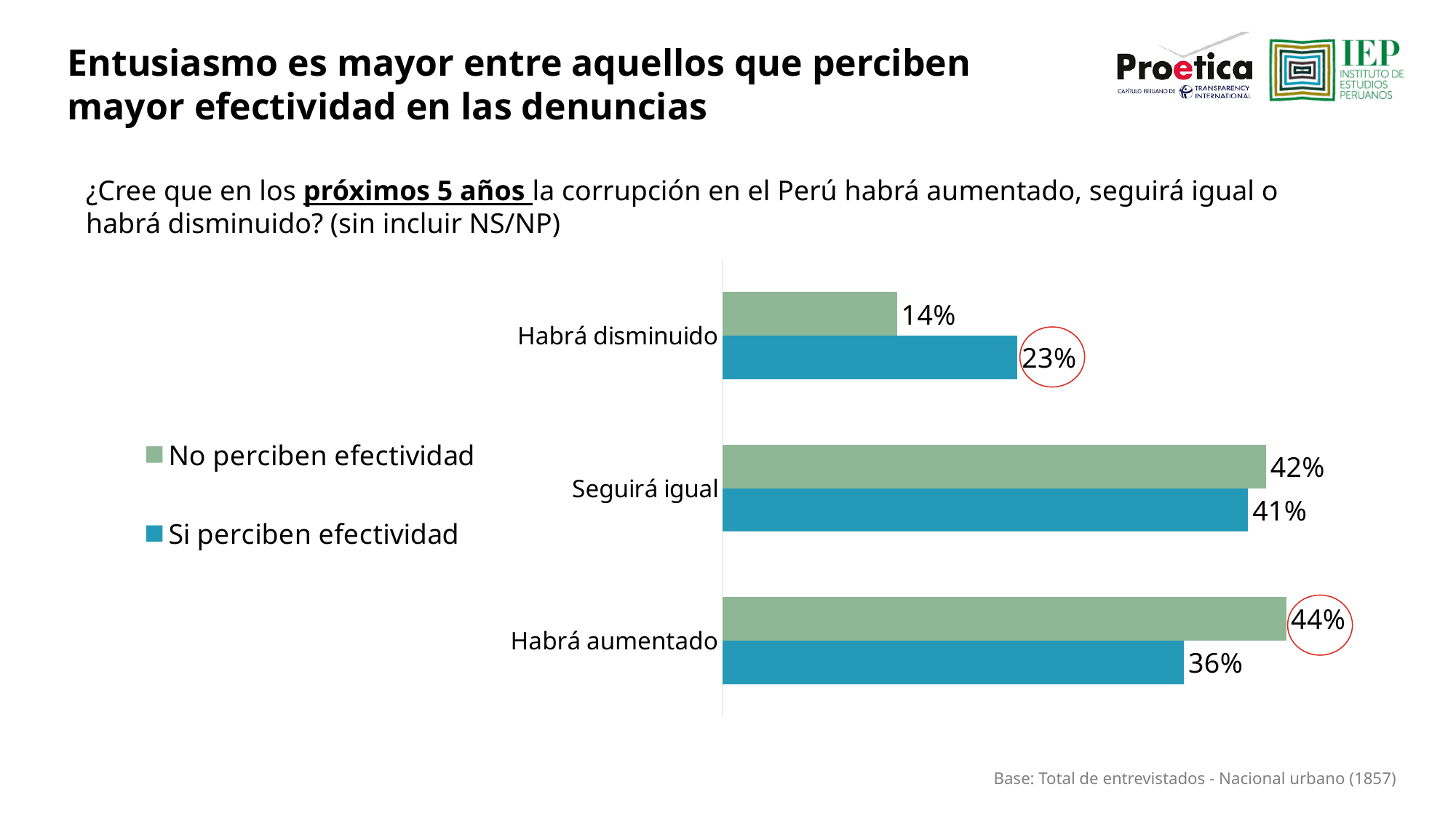
Which category has the lowest value for the 'Si perciben efectividad' series? Habrá disminuido Which category has the highest value for the 'No perciben efectividad' series? Habrá aumentado What is the difference between the 'No perciben efectividad' and 'Si perciben efectividad' values for 'Habrá aumentado'? 8 percentage points What percentage of those who do not perceive effectiveness (No perciben efectividad) say corruption will have decreased (Habrá disminuido)? 14% What type of chart is shown on the slide? Bar chart What percentage of those who perceive effectiveness (Si perciben efectividad) say corruption will have decreased (Habrá disminuido)? 23% How many series does the legend list? 2 What is the difference between the 'Si perciben efectividad' and 'No perciben efectividad' values for 'Habrá disminuido'? 9 percentage points What is the value for 'Seguirá igual' among those who perceive effectiveness (Si perciben efectividad)? 41% For 'Habrá disminuido', which series has the larger value: 'No perciben efectividad' or 'Si perciben efectividad'? Si perciben efectividad What is the value for 'Habrá aumentado' among those who do not perceive effectiveness (No perciben efectividad)? 44% How many response categories are shown on the chart? 3